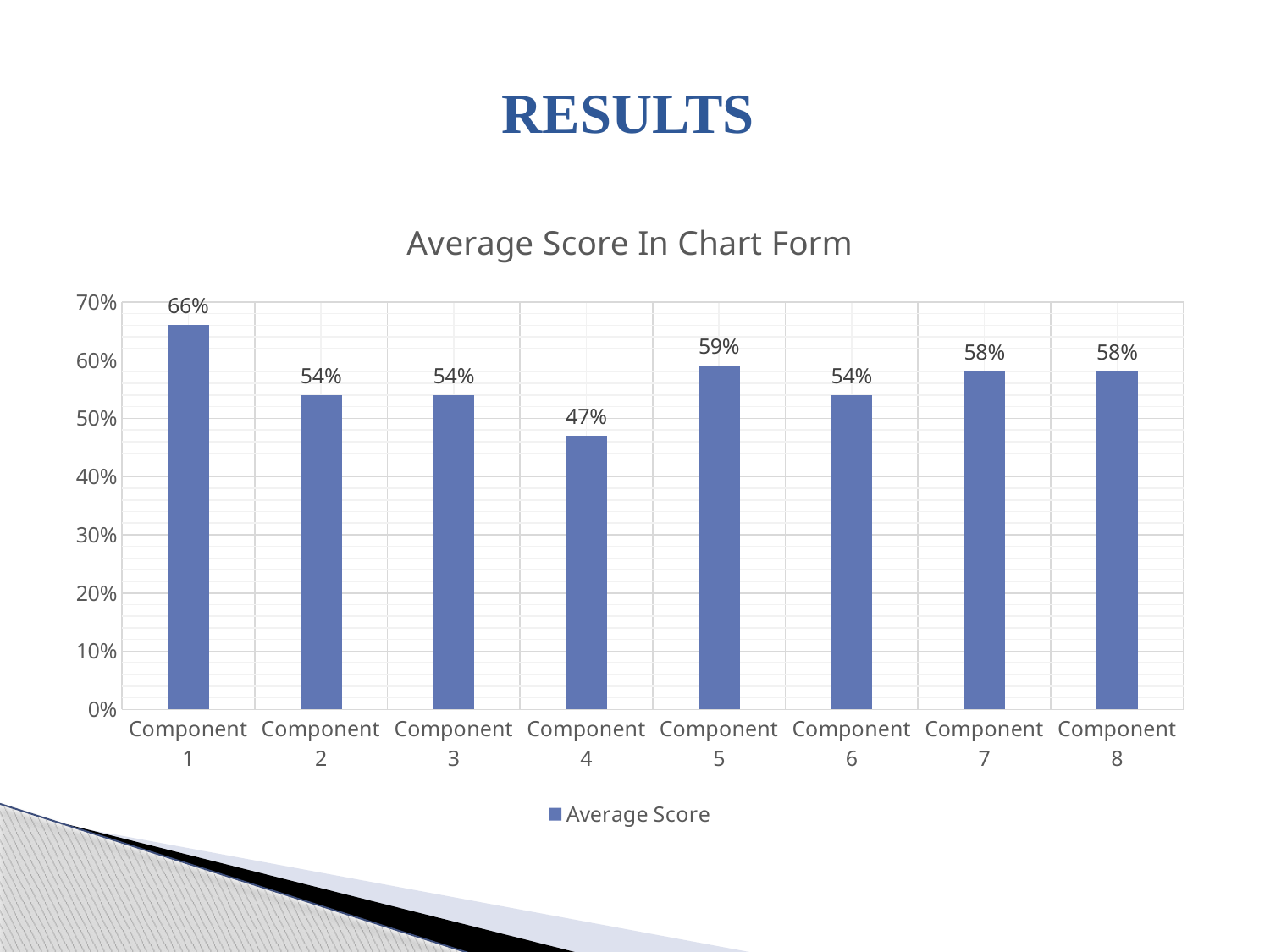
How many series does the legend list? 1 Which component has the lowest Average Score? Component 4 What is the difference between the Average Score for Component 1 and Component 4? 19% Is the value for Component 7 greater or less than 50%? greater What kind of chart is shown on the slide? Bar chart Which component has the highest Average Score? Component 1 What is the title of the chart? Average Score In Chart Form What is the Average Score for Component 1? 66% How many components are shown on the chart? 8 What is the Average Score for Component 4? 47% Which has a higher Average Score, Component 5 or Component 6? Component 5 What is the Average Score for Component 5? 59%